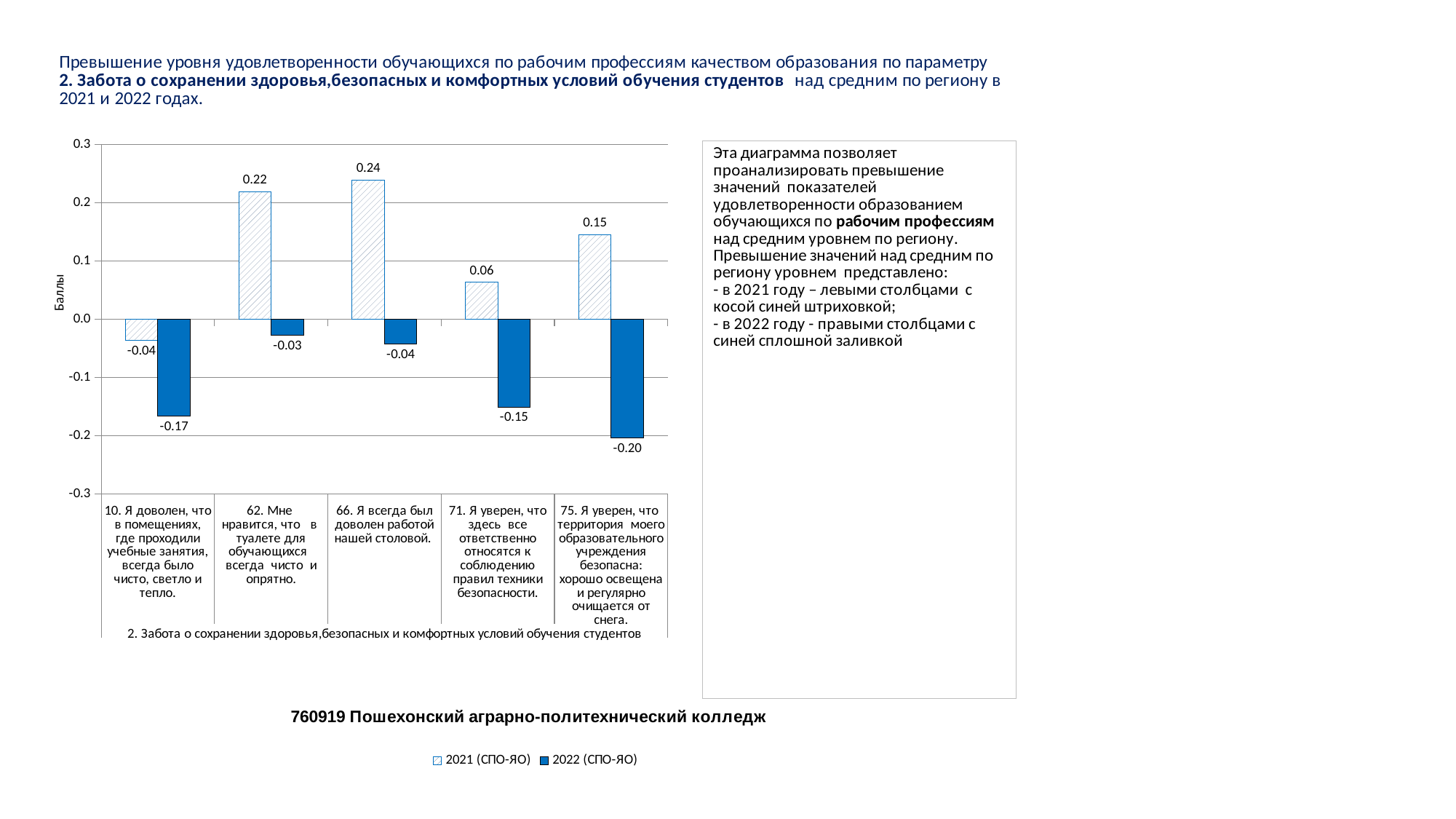
What is the 2022 (СПО-ЯО) value for statement 75 ("Я уверен, что территория моего образовательного учреждения безопасна")? -0.20 What is the 2022 (СПО-ЯО) value for statement 10 ("Я доволен, что в помещениях, где проходили учебные занятия, всегда было чисто, светло и тепло")? -0.17 Which statement has the lowest 2022 (СПО-ЯО) value? 75. Я уверен, что территория моего образовательного учреждения безопасна How many series does the legend list? 2 How many categories (statements) are shown on the x axis? 5 For statement 71 ("Я уверен, что здесь все ответственно относятся к соблюдению правил техники безопасности"), which series has the larger value, 2021 (СПО-ЯО) or 2022 (СПО-ЯО)? 2021 (СПО-ЯО) Which series is shown with solid blue fill according to the legend? 2022 (СПО-ЯО) What is the 2021 (СПО-ЯО) value for statement 66 ("Я всегда был доволен работой нашей столовой")? 0.24 Which statement has the highest 2021 (СПО-ЯО) value? 66. Я всегда был доволен работой нашей столовой. What type of chart is shown on the slide? bar chart What is the difference between the 2021 and 2022 values for statement 62 ("Мне нравится, что в туалете для обучающихся всегда чисто и опрятно")? 0.25 What is the label of the vertical axis? Баллы